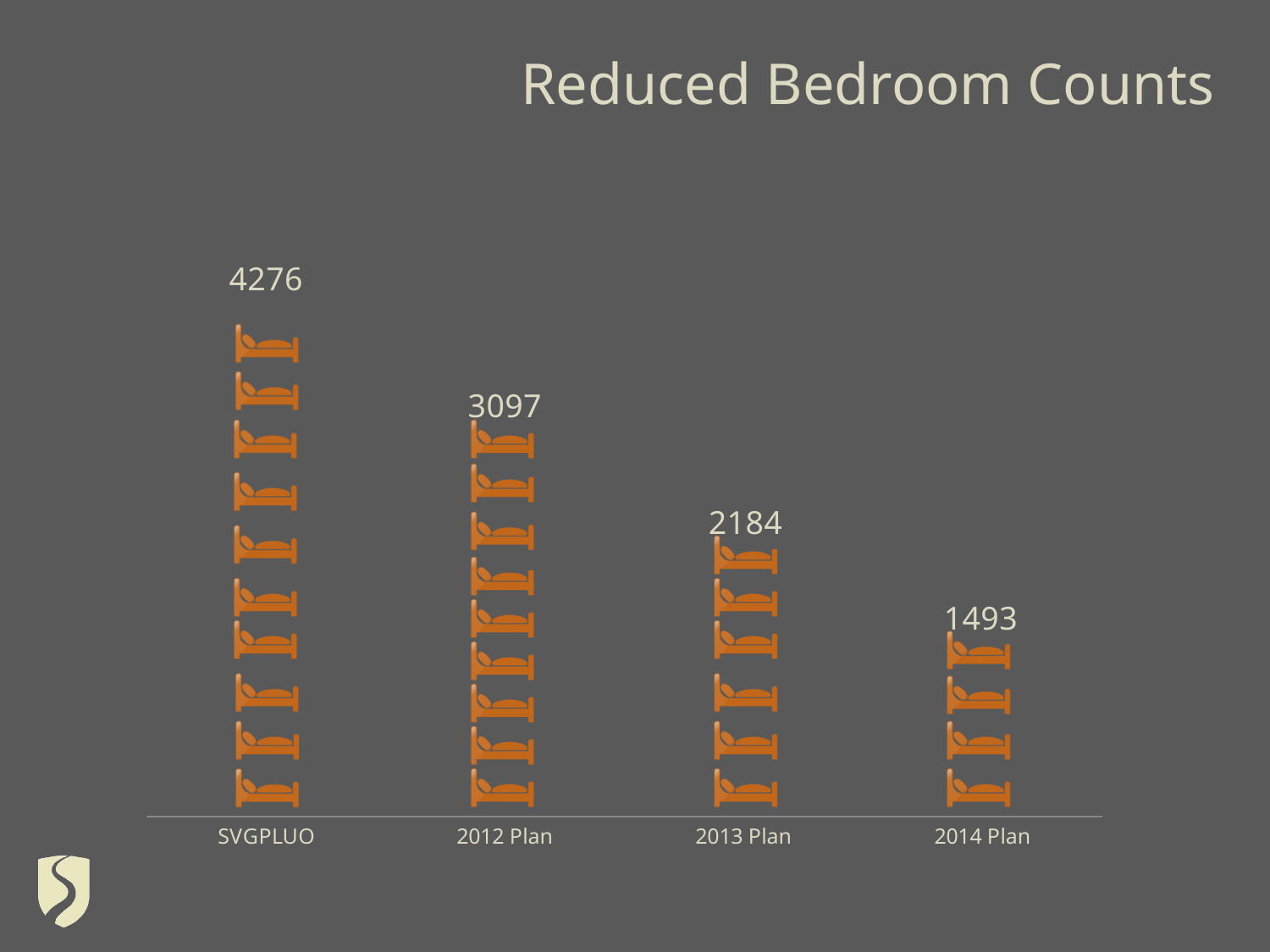
What is the bedroom count for the 2013 Plan? 2184 What is the difference in bedroom count between SVGPLUO and the 2014 Plan? 2783 Which category has the lowest bedroom count? 2014 Plan How many categories are shown on the chart? 4 What is the difference in bedroom count between the 2012 Plan and the 2013 Plan? 913 What is the bedroom count for the 2012 Plan? 3097 Which has a larger bedroom count, the 2013 Plan or the 2014 Plan? 2013 Plan Do the bedroom counts rise or fall from left to right across the chart? fall What is the bedroom count for the 2014 Plan? 1493 What is the title of the chart? Reduced Bedroom Counts Which category has the highest bedroom count? SVGPLUO What is the bedroom count for SVGPLUO? 4276